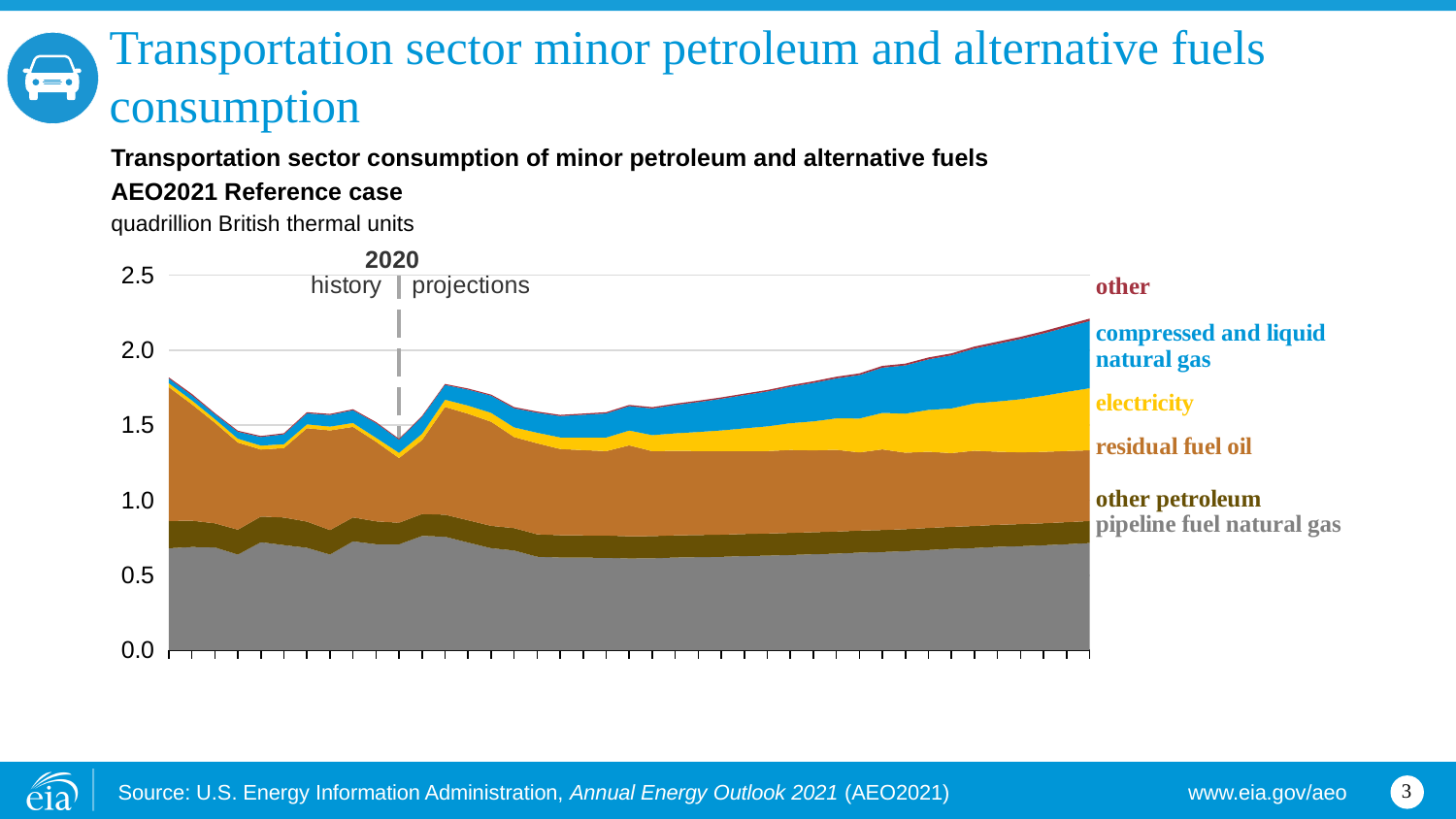
How many fuel series are labelled on the chart? 6 Which year separates history from projections on the chart? 2020 Which series is larger at the right end of the chart, compressed and liquid natural gas or other petroleum? compressed and liquid natural gas Is the total consumption at the 2020 dividing line greater or less than 1.5? less Which series forms the bottom layer of the stacked area chart? pipeline fuel natural gas Is the pipeline fuel natural gas value at the right end of the chart greater or less than 1.0? less Is the pipeline fuel natural gas value at the right end of the chart greater or less than 0.5? greater What unit is the chart's y axis measured in? quadrillion British thermal units What kind of chart is shown on the slide? stacked area chart Does total consumption rise or fall over the projection period after 2020? rise